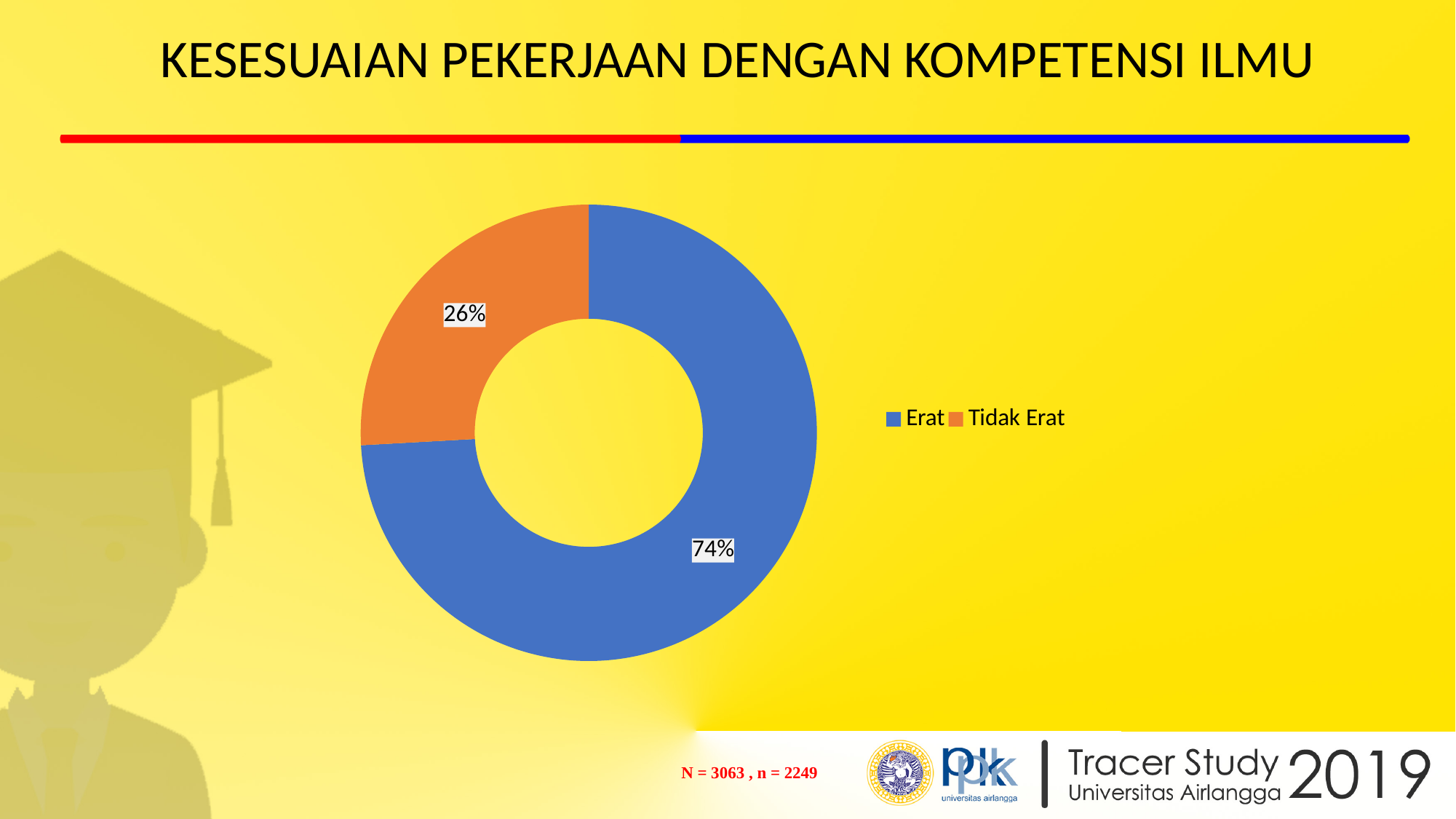
What is the total of the two percentages shown on the chart? 100% How many categories does the chart show? 2 What is the difference in percentage points between the Erat and Tidak Erat slices? 48 What colour is the Tidak Erat slice? Orange Which is larger, the Erat slice or the Tidak Erat slice? Erat How many entries does the legend list? 2 What is the title of the slide? KESESUAIAN PEKERJAAN DENGAN KOMPETENSI ILMU What kind of chart is shown on the slide? Doughnut (pie) chart What percentage of the chart is labelled Erat? 74% Which category has the smallest share of the chart? Tidak Erat What percentage of the chart is labelled Tidak Erat? 26% Which category has the largest share of the chart? Erat